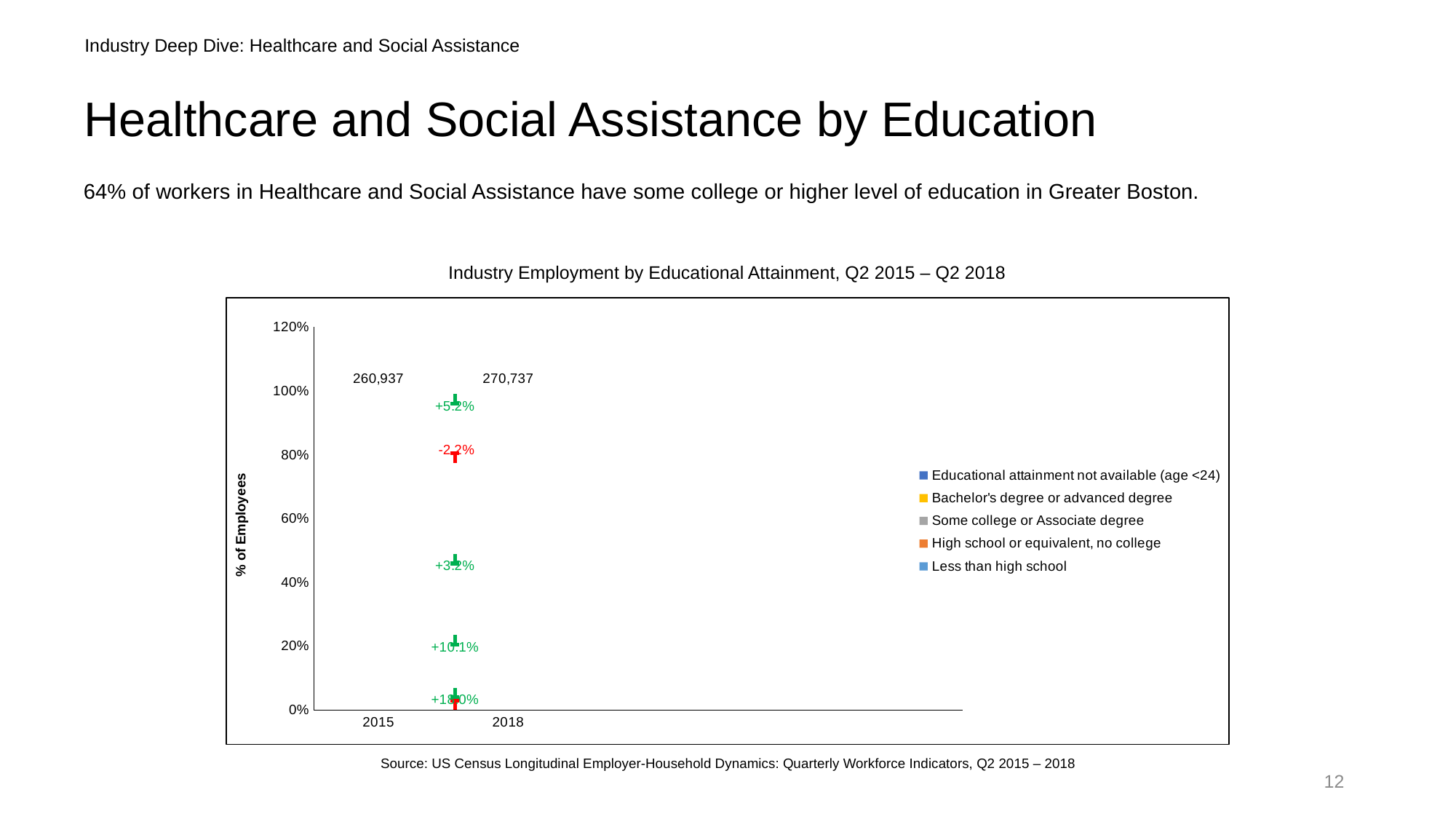
What is the label on the y axis of the chart? % of Employees What is the difference between the total employment figures printed for 2018 and 2015 in the chart? 9,800 What total employment figure is printed above the 2015 column in the chart? 260,937 How many entries does the chart's legend list? 5 What is the highest value shown on the y axis of the chart? 120% Which year has the larger total employment figure printed in the chart, 2015 or 2018? 2018 What are the two categories on the x axis of the chart? 2015 and 2018 Is the total employment figure printed for 2018 greater or less than 270,000? greater Is the total employment figure printed for 2015 greater or less than 270,000? less What is the title of the chart? Industry Employment by Educational Attainment, Q2 2015 – Q2 2018 How many categories are shown on the x axis of the chart? 2 What total employment figure is printed above the 2018 column in the chart? 270,737